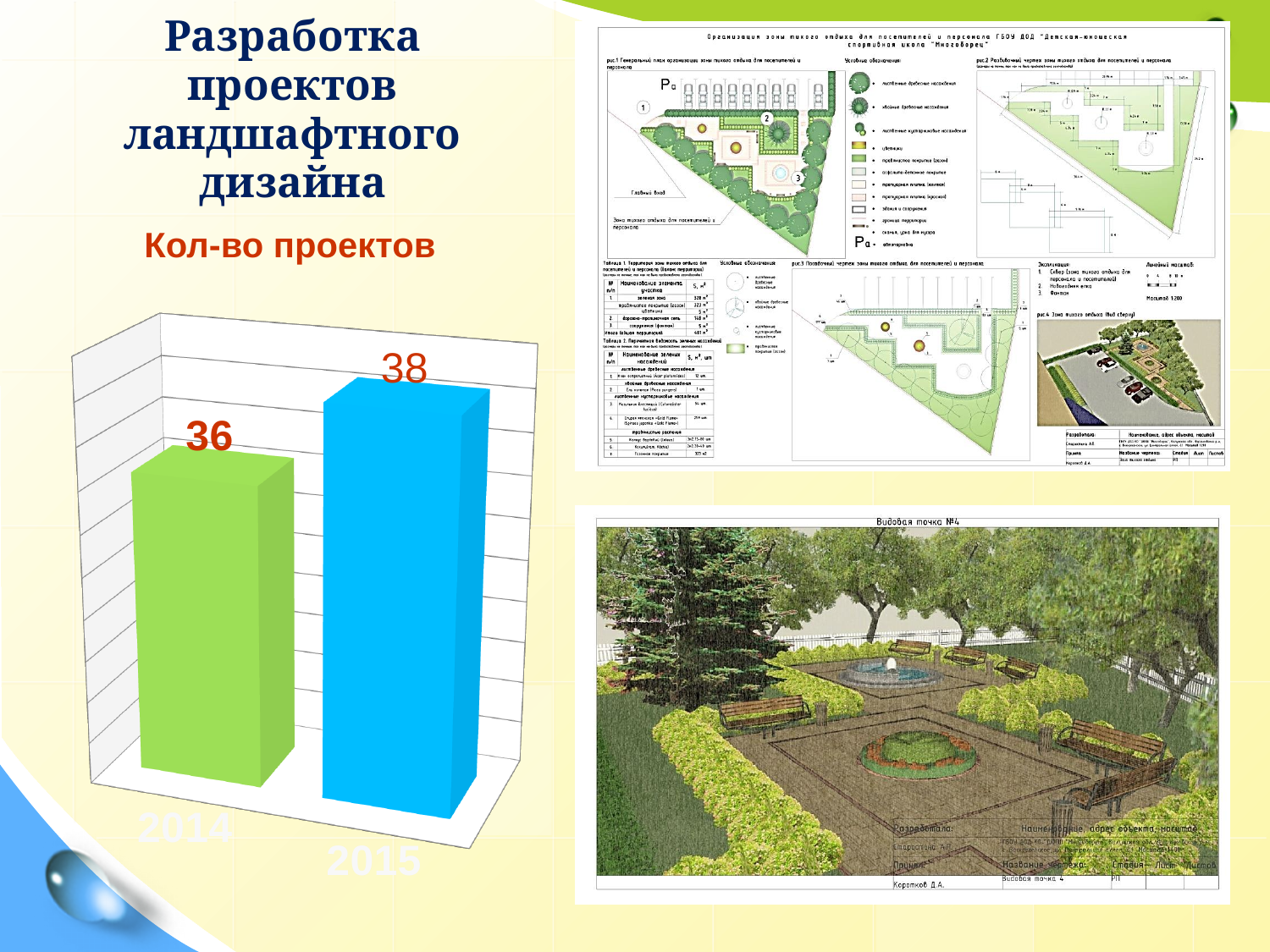
How many categories are shown in the chart? 2 What is the difference between the values for 2015 and 2014? 2 Which is larger, the value for 2014 or the value for 2015? 2015 Which year has the lowest value? 2014 What is the value for 2014? 36 Do the values rise or fall from 2014 to 2015? rise What colour is the bar for 2015? blue Which year has the highest value? 2015 What is the value for 2015? 38 What kind of chart is shown on the slide? bar chart What is the title of the chart? Кол-во проектов